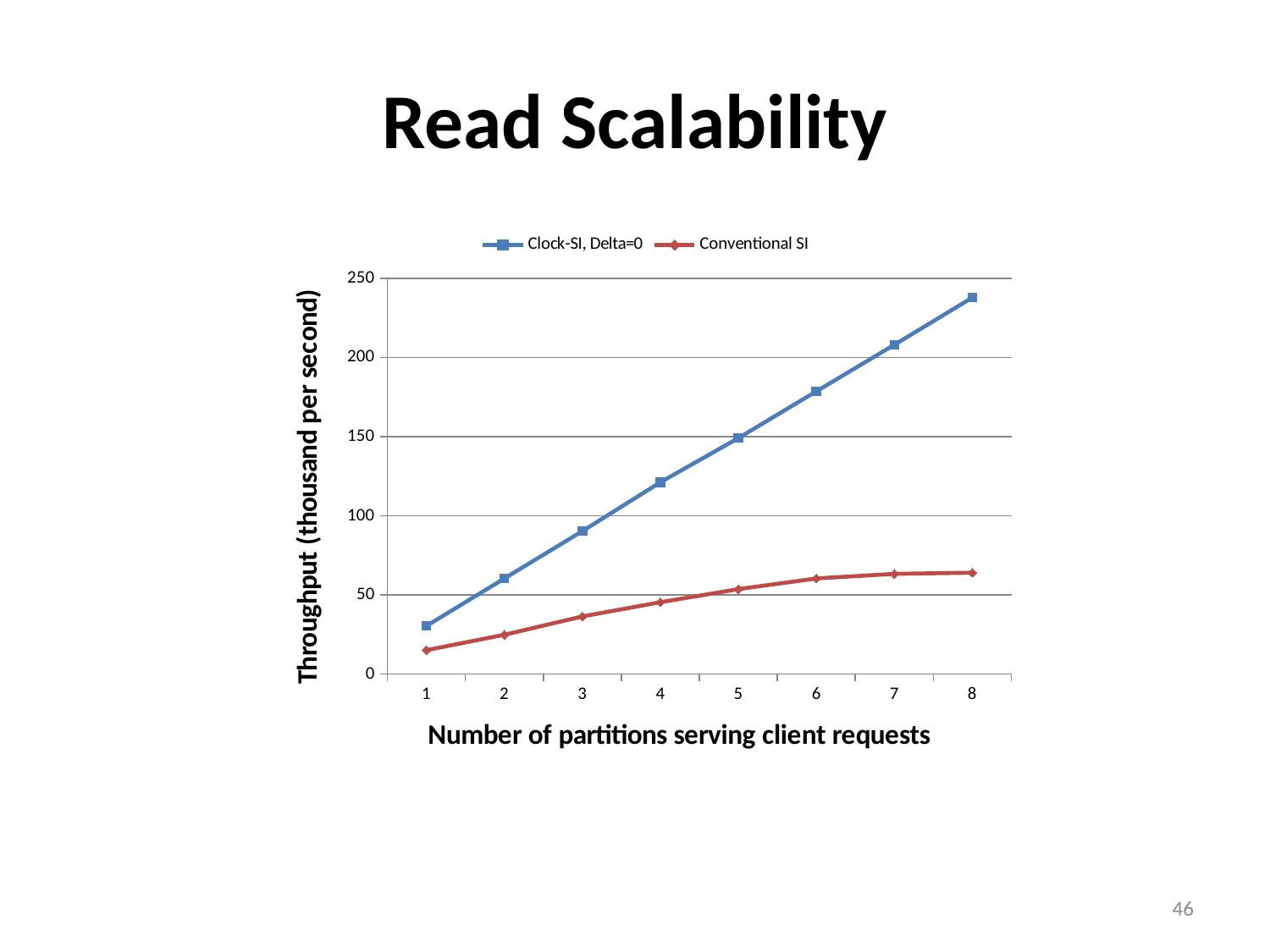
Is the Clock-SI, Delta=0 throughput at 8 partitions greater or less than 200? greater How many series does the legend list? 2 At 8 partitions, which series has the higher throughput, Clock-SI, Delta=0 or Conventional SI? Clock-SI, Delta=0 At which number of partitions does the Clock-SI, Delta=0 series reach its highest throughput? 8 Is the Clock-SI, Delta=0 throughput at 4 partitions greater or less than 100? greater Is the Clock-SI, Delta=0 throughput at 1 partition greater or less than 50? less What kind of chart is shown on the slide? line chart Does the Clock-SI, Delta=0 throughput rise or fall as the number of partitions increases? rise What is the title of the y axis? Throughput (thousand per second) How many x-axis points (numbers of partitions) are plotted for each series? 8